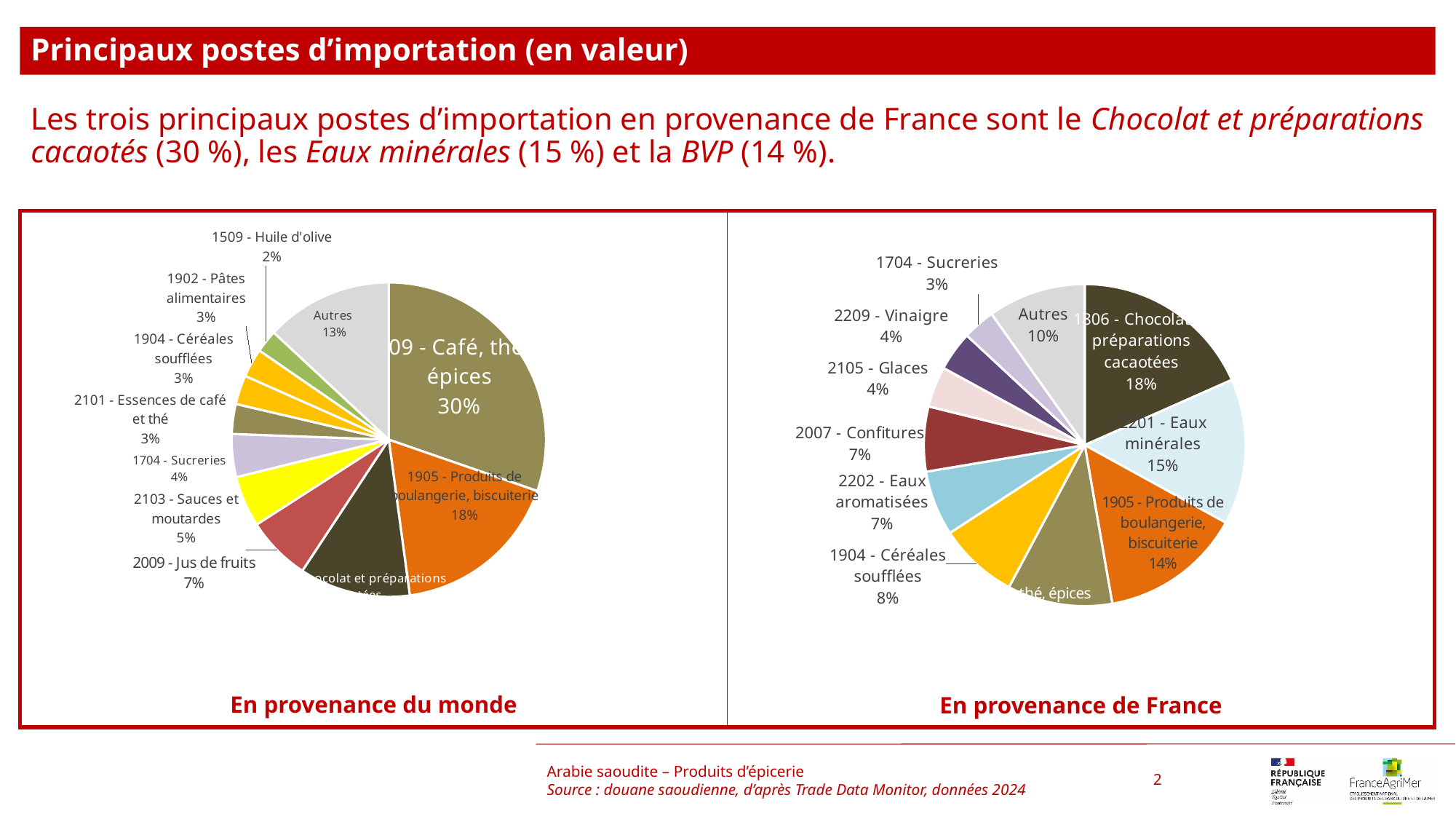
In the 'En provenance du monde' chart, what share does '1509 - Huile d'olive' have? 2% In the 'En provenance de France' chart, what share does 'Autres' have? 10% In the 'En provenance de France' chart, what share does '2201 - Eaux minérales' have? 15% In the 'En provenance du monde' chart, what share does '2009 - Jus de fruits' have? 7% What type of chart is used on this slide? Pie chart In the 'En provenance du monde' chart, what is the difference between the shares of '1905 - Produits de boulangerie, biscuiterie' and '2103 - Sauces et moutardes'? 13 percentage points In the 'En provenance de France' chart, which is larger: '2007 - Confitures' or '2105 - Glaces'? 2007 - Confitures In the 'En provenance de France' chart, what share does '1904 - Céréales soufflées' have? 8% In the 'En provenance de France' chart, what is the difference between the shares of '1806 - Chocolat et préparations cacaotées' and '1905 - Produits de boulangerie, biscuiterie'? 4 percentage points In the 'En provenance du monde' chart, which labelled category has the largest share? 09 - Café, thé, épices How many slices does the 'En provenance de France' pie chart have? 11